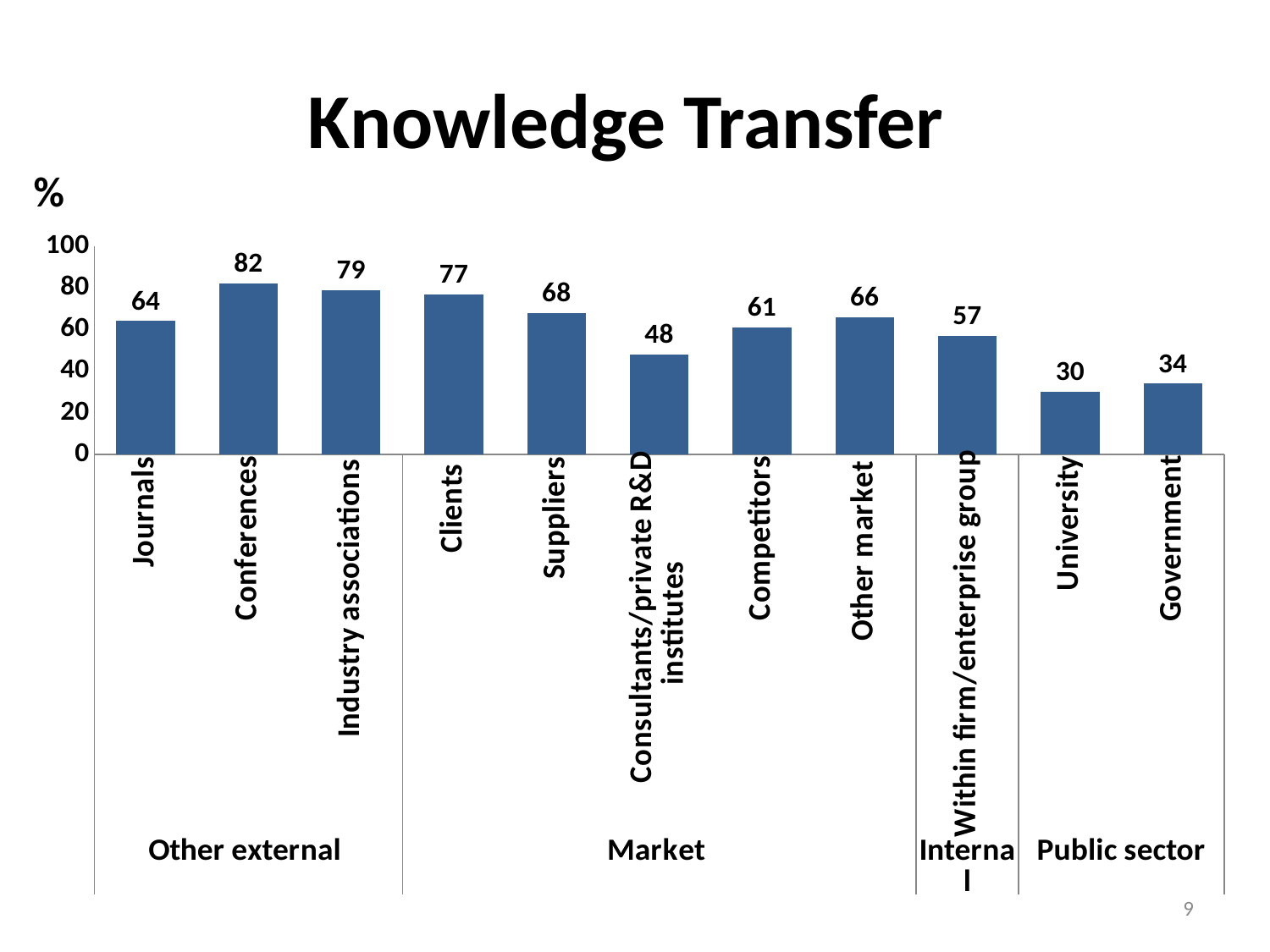
Which is larger, the value for Journals or the value for Other market? Other market Which category has the highest value? Conferences What is the difference between the values for Clients and Suppliers? 9 What is the value for Consultants/private R&D institutes? 48 What is the value for Within firm/enterprise group? 57 What is the title of the chart? Knowledge Transfer How many categories are shown in the chart? 11 What kind of chart is shown on the slide? Bar chart Which category has the lowest value? University Which group label contains the categories University and Government? Public sector What is the value for Conferences? 82 Is the value for Government greater or less than 40? less